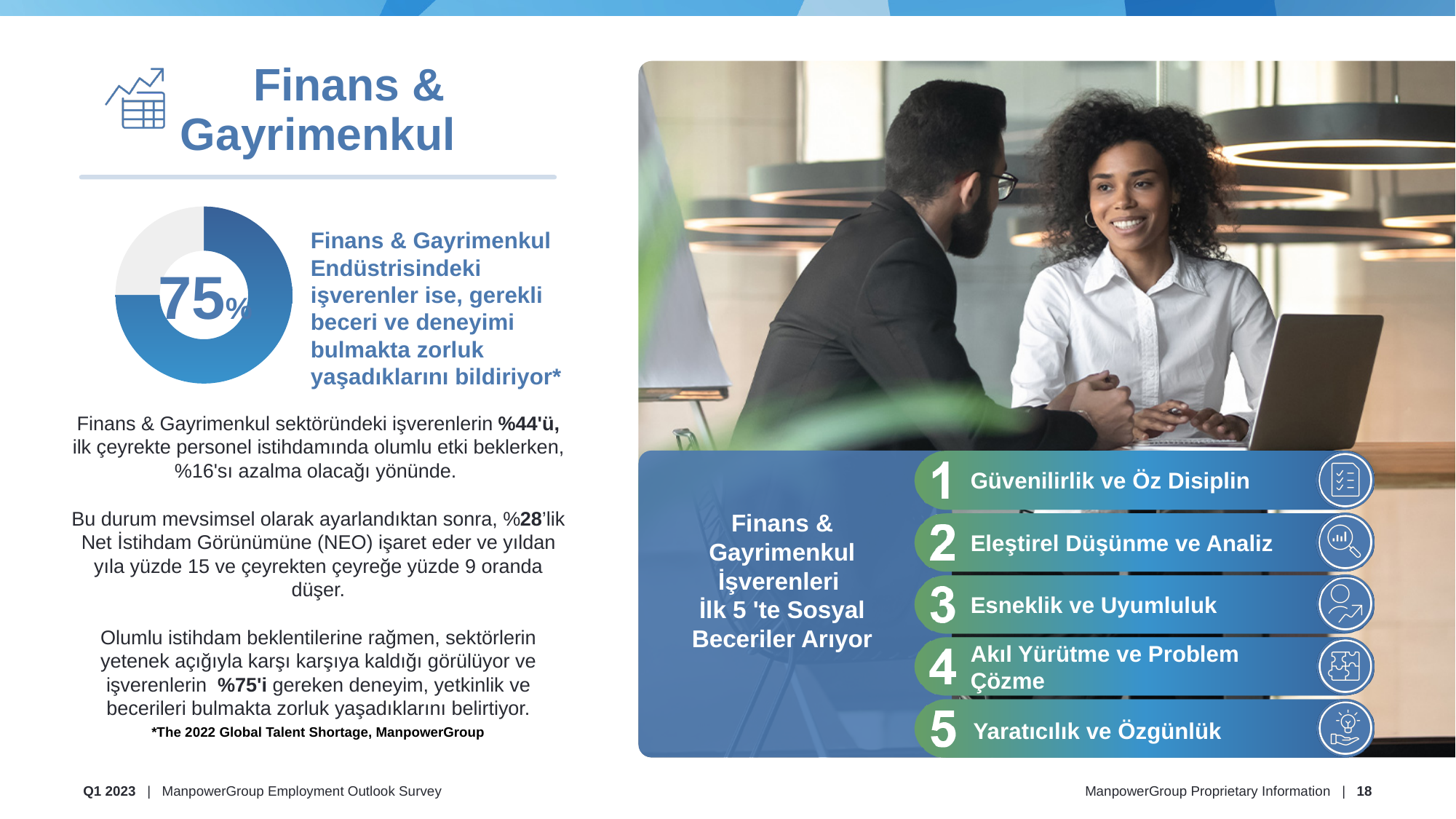
Which segment of the donut chart is larger, the blue one or the grey one? The blue one What kind of chart is shown on the left of the slide? Donut (pie) chart How many segments does the donut chart have? 2 What share of the donut chart is filled in blue? 75% What percentage is printed in the centre of the donut chart? 75% Is the value shown in the donut chart greater or less than 50%? greater According to the text next to the donut chart, what does the 75% represent? Finans & Gayrimenkul employers reporting difficulty finding required skills and experience What colour is the filled portion of the donut chart? Blue